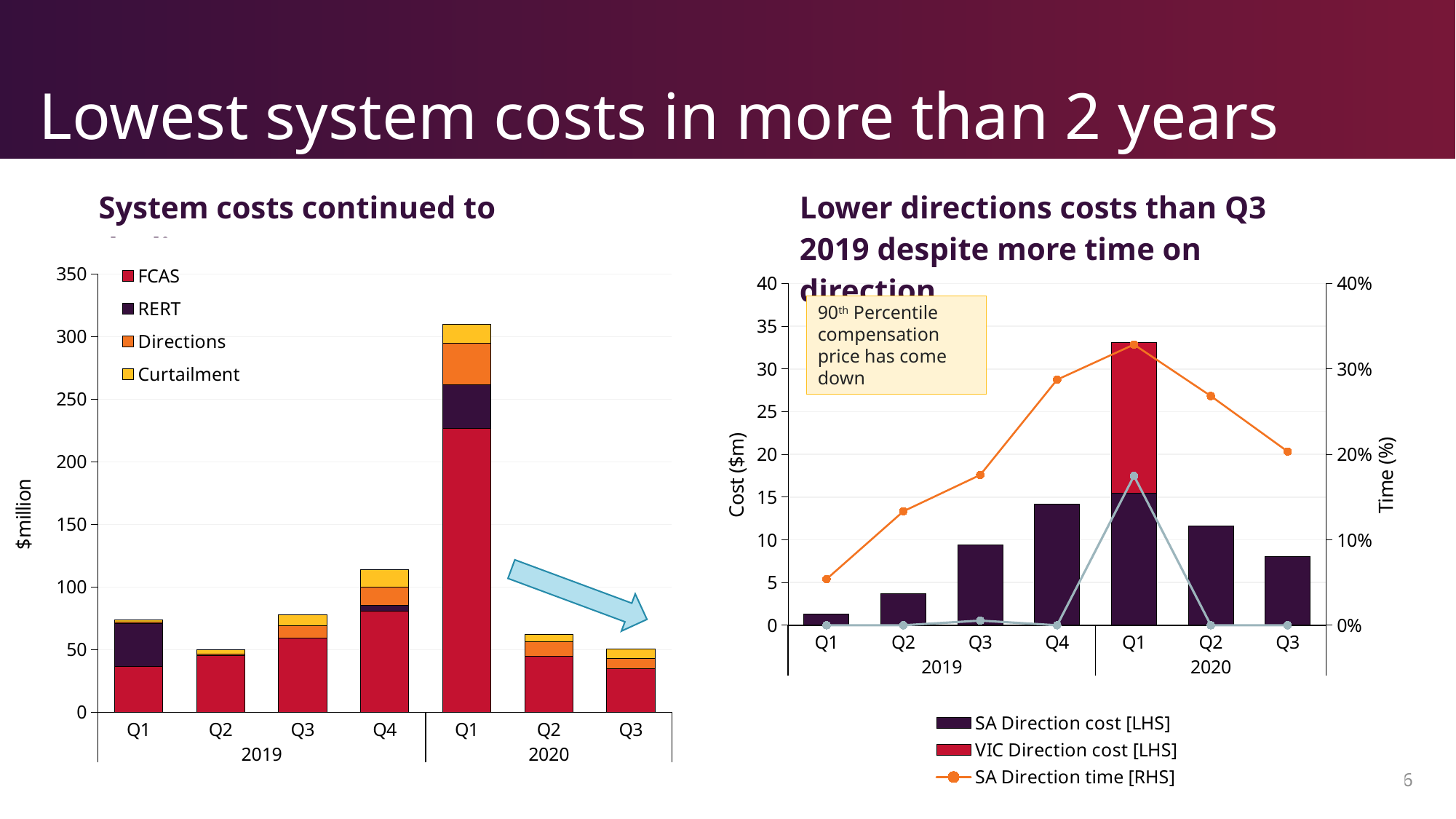
On the left chart (System costs), what kind of chart is it? Stacked bar chart On the right chart (Lower directions costs), in which quarter is SA Direction cost lowest? Q1 2019 On the left chart (System costs), how many quarters are plotted on the x axis? 7 On the left chart (System costs), which quarter has the highest total system cost? Q1 2020 On the left chart (System costs), how many series does the legend list? 4 On the right chart (Lower directions costs), in which quarter is SA Direction time highest? Q1 2020 On the right chart (Lower directions costs), is the SA Direction cost for Q3 2020 greater or less than 10? less On the left chart (System costs), do total system costs rise or fall from Q1 2020 to Q3 2020? Fall On the left chart (System costs), which has the larger total: Q2 2019 or Q3 2019? Q3 2019 On the left chart (System costs), is the total for Q1 2019 greater or less than 100? less On the left chart (System costs), is the total for Q1 2020 greater or less than 250? greater On the right chart (Lower directions costs), how many entries does the legend list? 3